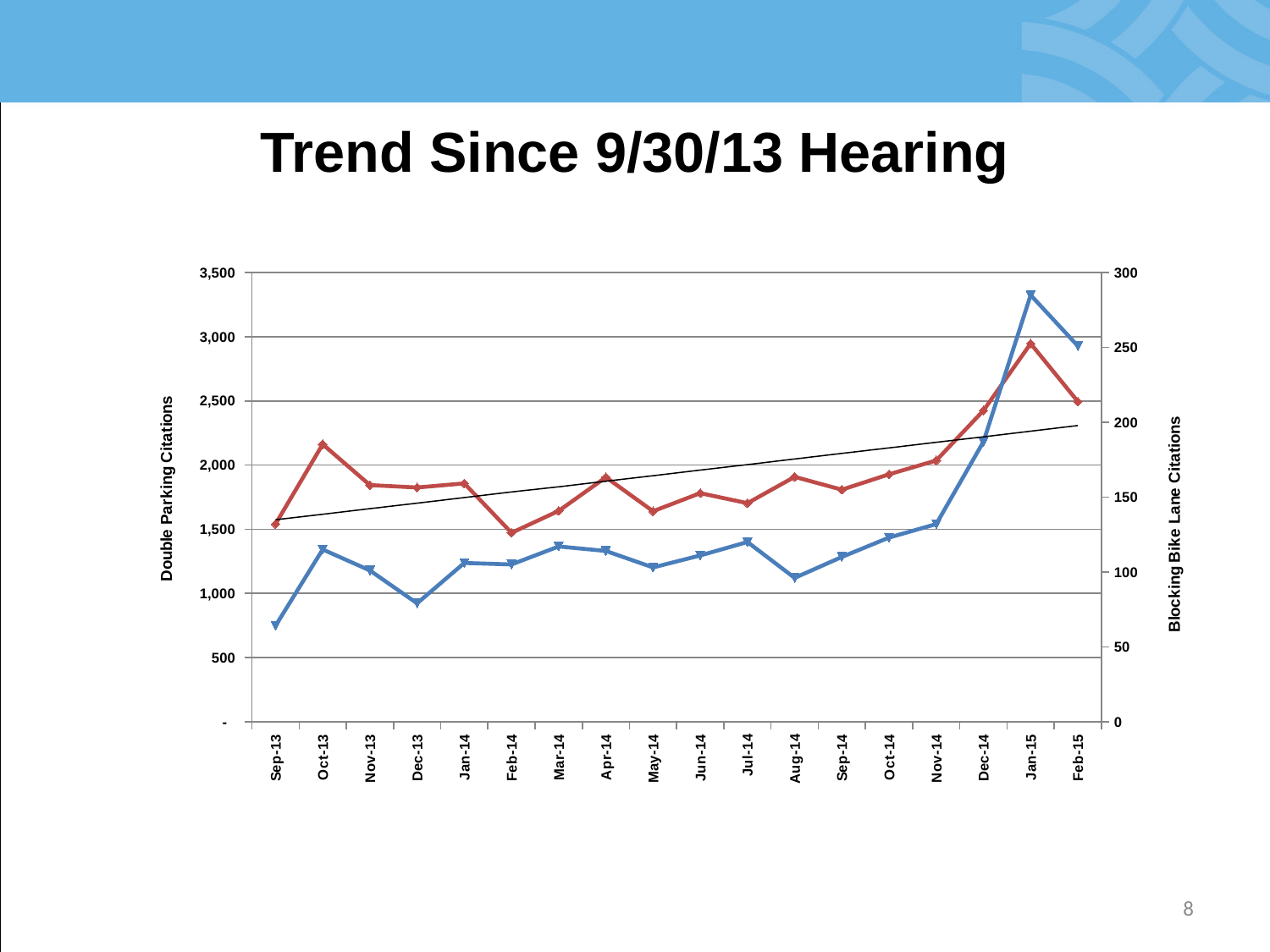
How many months are plotted along the x axis? 18 What is the title of the left vertical axis? Double Parking Citations In which month does the blue line reach its highest point? Jan-15 Does the straight black trend line rise or fall from Sep-13 to Feb-15? rise What is the first month shown on the x axis? Sep-13 What is the last month shown on the x axis? Feb-15 In which month does the red line reach its highest point? Jan-15 In which month is the blue line at its lowest point? Sep-13 Read against the left axis, is the red line's value at Oct-13 greater or less than 2,000? greater What kind of chart is shown on the slide? line chart